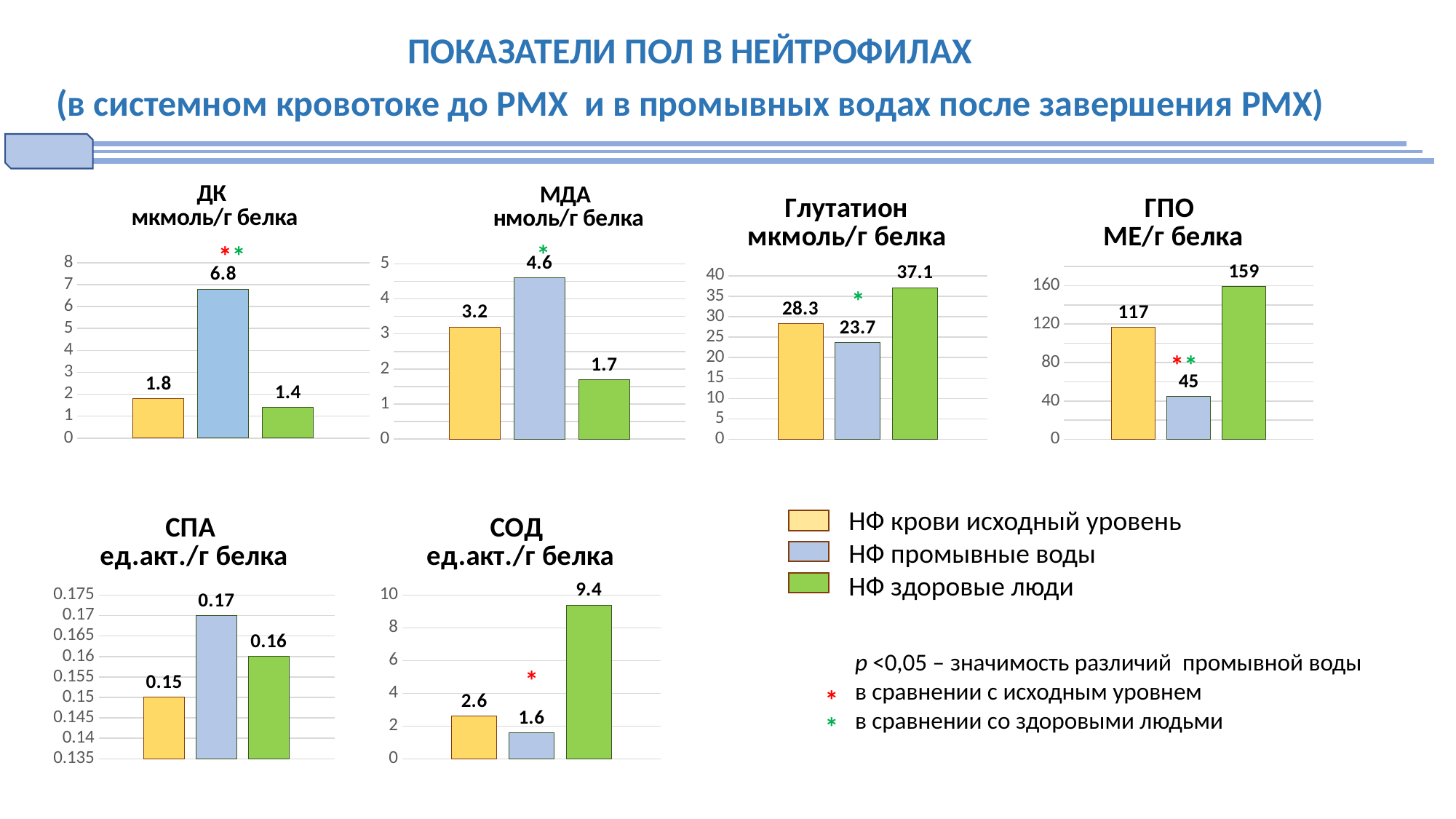
In the ГПО chart, what is the difference between the values for НФ здоровые люди and НФ промывные воды? 114 In the Глутатион chart, what is the difference between the values for НФ здоровые люди and НФ крови исходный уровень? 8.8 In the ГПО chart, which group has the highest value? НФ здоровые люди In the МДА chart, what is the value for НФ здоровые люди? 1.7 In the ДК chart, what is the value for НФ промывные воды? 6.8 In the Глутатион chart, which group has the lowest value? НФ промывные воды In the СПА chart, what is the value for НФ крови исходный уровень? 0.15 How many series does the legend list? 3 What type of chart is the МДА chart? Bar chart How many bars are plotted in the СОД chart? 3 In the СОД chart, which is larger: the value for НФ крови исходный уровень or the value for НФ промывные воды? НФ крови исходный уровень What colour represents НФ здоровые люди in the legend? Green